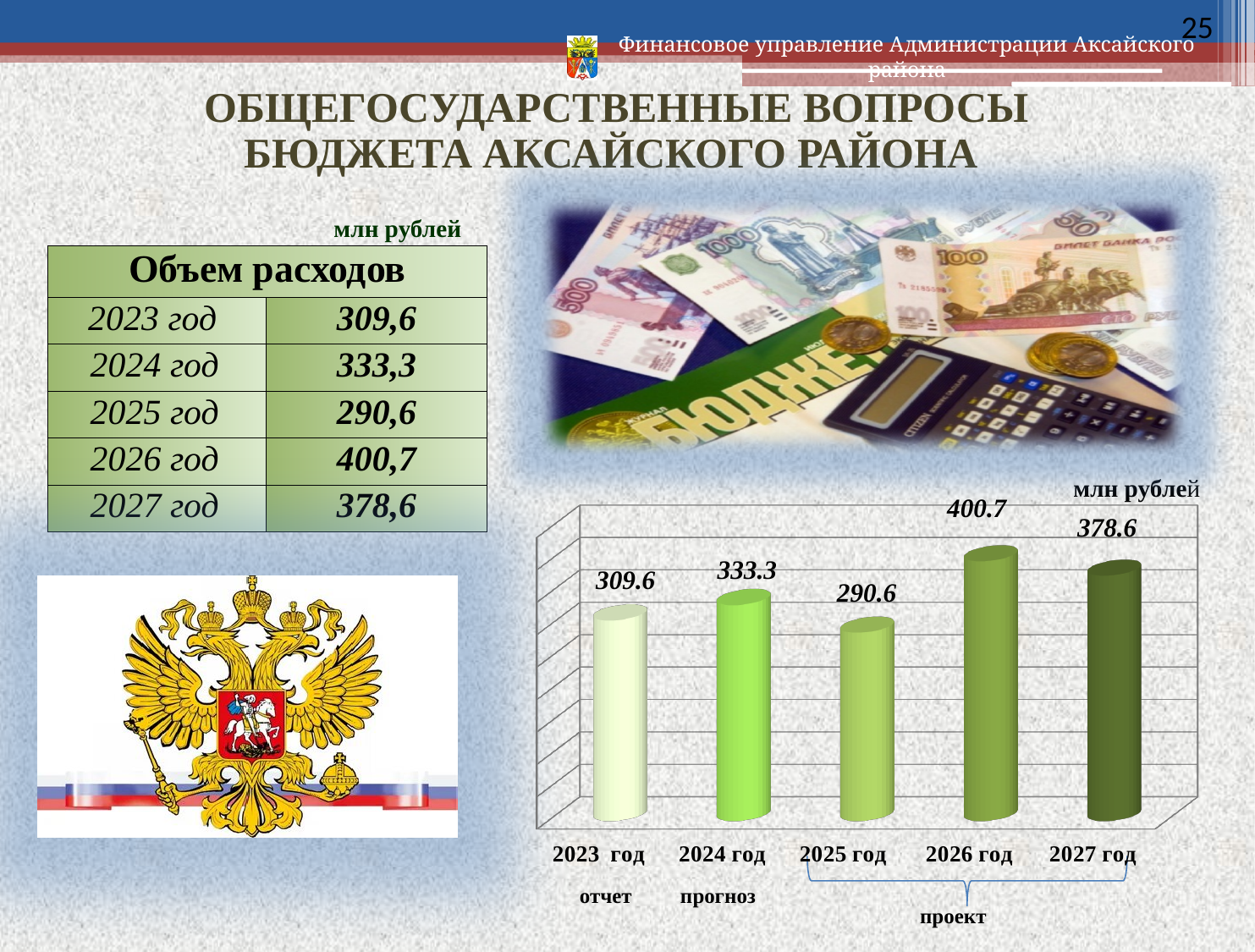
What is the difference between the values for 2024 год and 2025 год on the bar chart? 42.7 What is the difference between the values for 2026 год and 2027 год on the bar chart? 22.1 What kind of chart is shown on the slide? Bar chart Which is larger on the bar chart, the value for 2023 год or the value for 2024 год? 2024 год Which year has the highest value on the bar chart? 2026 год What is the value shown for 2026 год on the bar chart? 400.7 Which year has the lowest value on the bar chart? 2025 год What is the value shown for 2024 год on the bar chart? 333.3 How many bars are shown on the bar chart? 5 What unit is indicated above the bar chart? млн рублей What is the value shown for 2027 год on the bar chart? 378.6 What is the value shown for 2023 год on the bar chart? 309.6